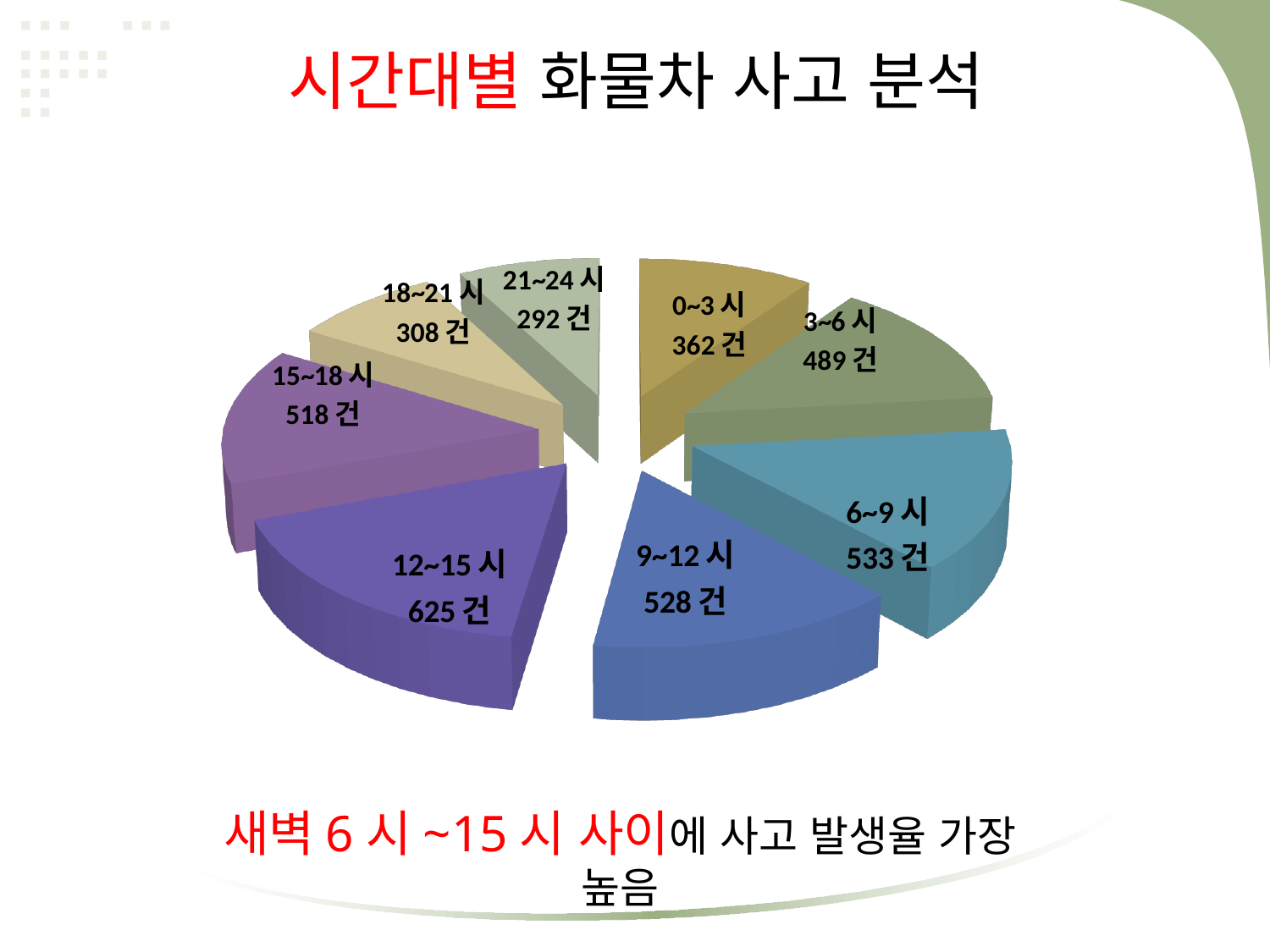
How many accidents are shown for the 0~3 시 period? 362 건 Which time period has the lowest number of accidents? 21~24 시 How many accidents are shown for the 18~21 시 period? 308 건 What is the total number of accidents across all time periods in the pie chart? 3655 건 Which has more accidents, the 6~9 시 period or the 9~12 시 period? 6~9 시 What is the difference in accidents between the 12~15 시 and 21~24 시 periods? 333 건 What kind of chart is shown on the slide? Pie chart What is the title of the chart on the slide? 시간대별 화물차 사고 분석 What is the difference in accidents between the 3~6 시 and 0~3 시 periods? 127 건 How many accidents are shown for the 12~15 시 period? 625 건 Which time period has the highest number of accidents? 12~15 시 How many time-period slices does the pie chart have? 8